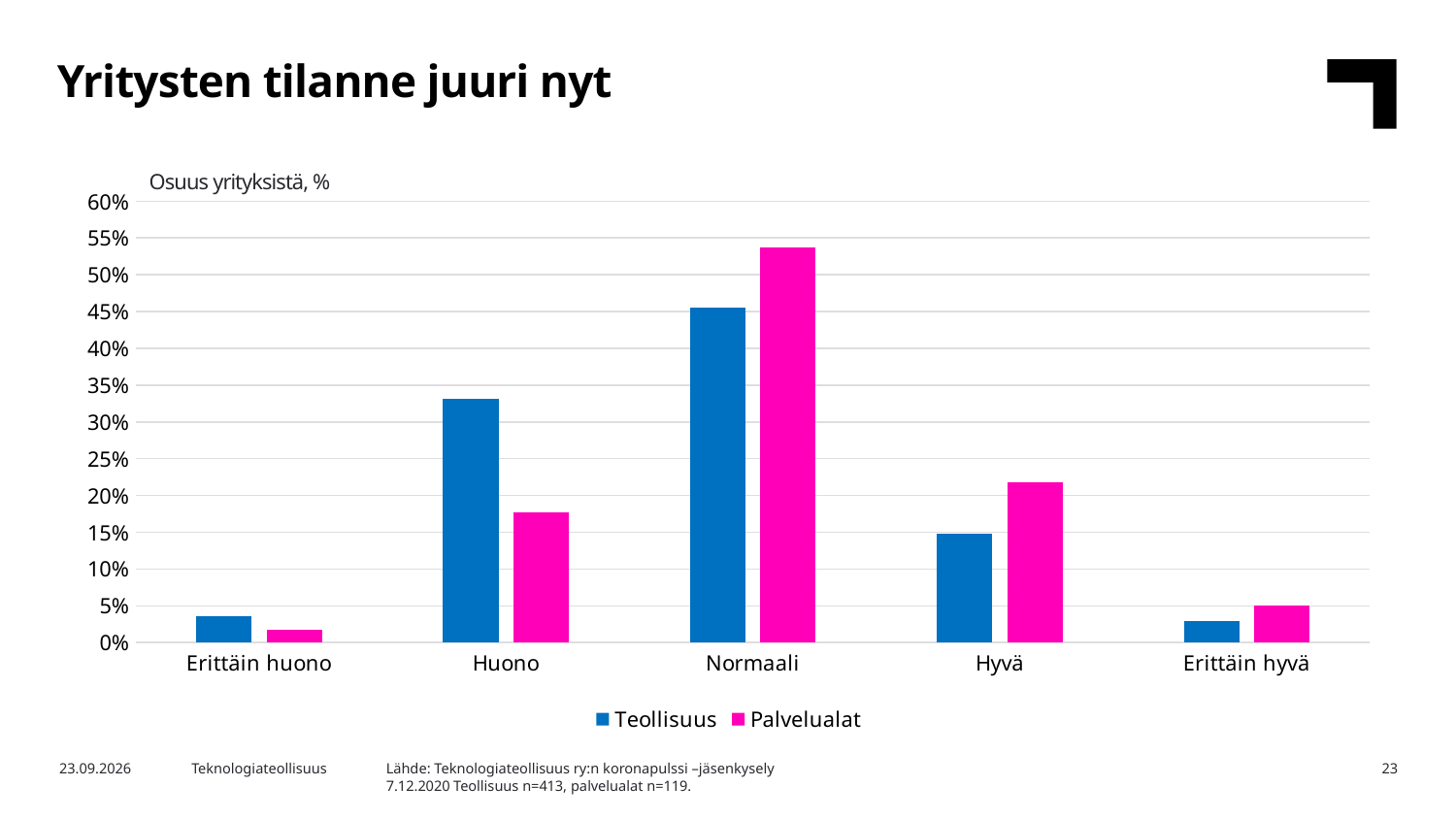
In the Huono category, which series has the larger value, Teollisuus or Palvelualat? Teollisuus How many series does the legend list? 2 Which category has the highest value for Teollisuus? Normaali Is the value for Palvelualat in the Hyvä category greater or less than 25%? less Is the value for Palvelualat in the Normaali category greater or less than 50%? greater Which category has the lowest value for Palvelualat? Erittäin huono What kind of chart is shown on the slide? Bar chart How many categories are shown on the x axis? 5 Which category has the highest value for Palvelualat? Normaali What is the title of the slide? Yritysten tilanne juuri nyt In the Hyvä category, which series has the larger value, Teollisuus or Palvelualat? Palvelualat Is the value for Teollisuus in the Huono category greater or less than 30%? greater